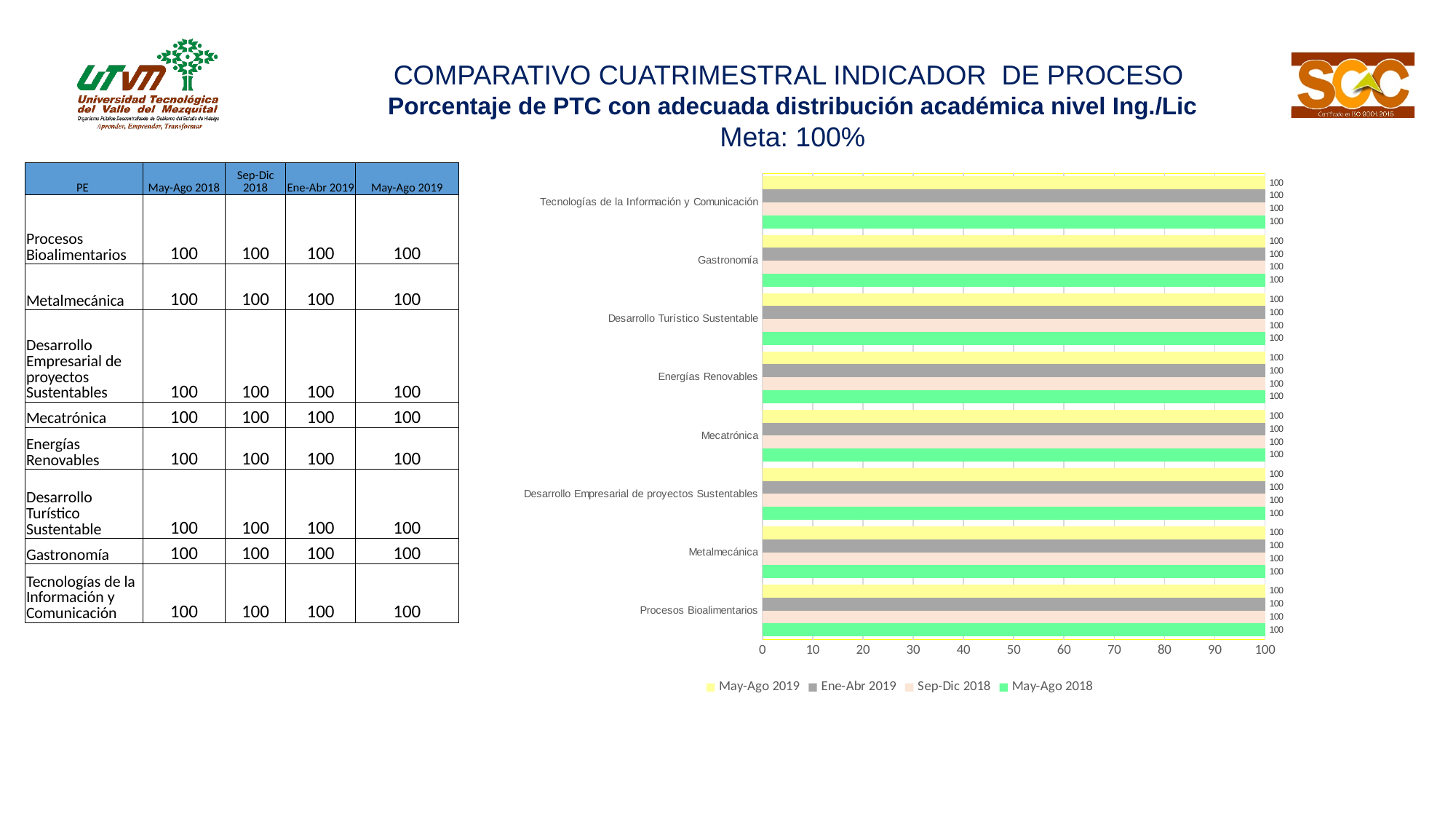
What is the difference between the May-Ago 2019 value for Metalmecánica and the May-Ago 2018 value for Metalmecánica? 0 What is the value for Gastronomía in the May-Ago 2019 series? 100 What colour are the bars for the May-Ago 2018 series? green Which series is listed first in the chart legend? May-Ago 2019 How many categories (programs) are plotted on the chart? 8 What kind of chart is shown on the slide? bar chart What is the value for Procesos Bioalimentarios in the May-Ago 2018 series? 100 What is the highest value shown on the chart's horizontal axis? 100 How many series does the chart legend list? 4 What is the value for Mecatrónica in the Ene-Abr 2019 series? 100 Is the value for Desarrollo Turístico Sustentable in the Ene-Abr 2019 series greater or less than 90? greater What is the value for Energías Renovables in the Sep-Dic 2018 series? 100